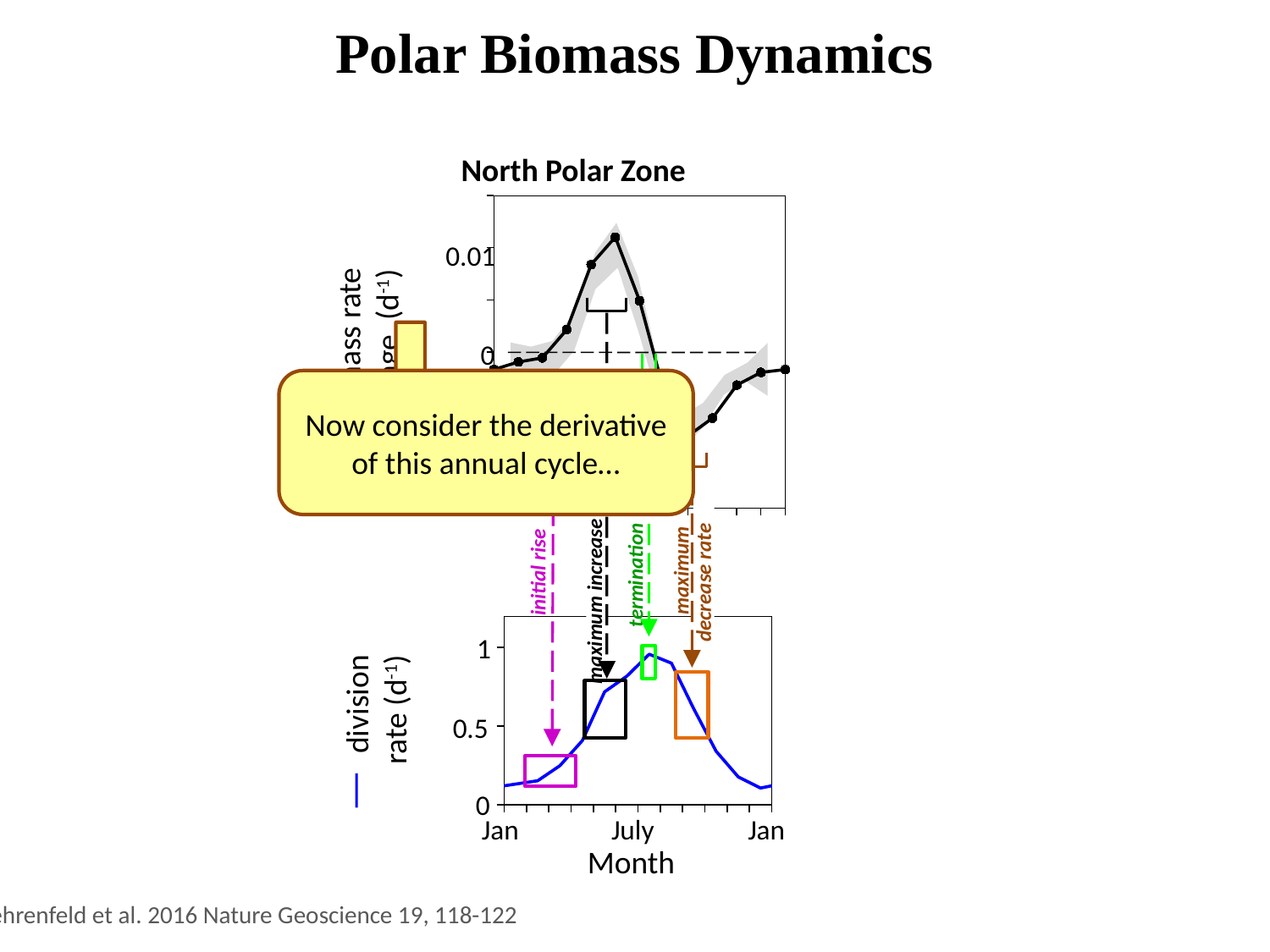
What colour is the division rate line in the bottom chart? blue How many labelled phase annotations (initial rise, maximum increase, termination, maximum decrease rate) point to the bottom chart? 4 In the bottom chart, does the division rate rise or fall from July to the following January? fall In the top North Polar Zone chart, is the biomass rate of change at the start of the year greater or less than 0.01? less In the bottom chart, is the division rate in January greater or less than 0.5? less In the top North Polar Zone chart, is the peak biomass rate of change greater or less than 0.01? greater In the bottom chart, what is the label of the x axis? Month What is the title of the top chart? North Polar Zone In the bottom chart, does the division rate rise or fall from January to July? rise What type of chart is the bottom chart showing division rate? line chart